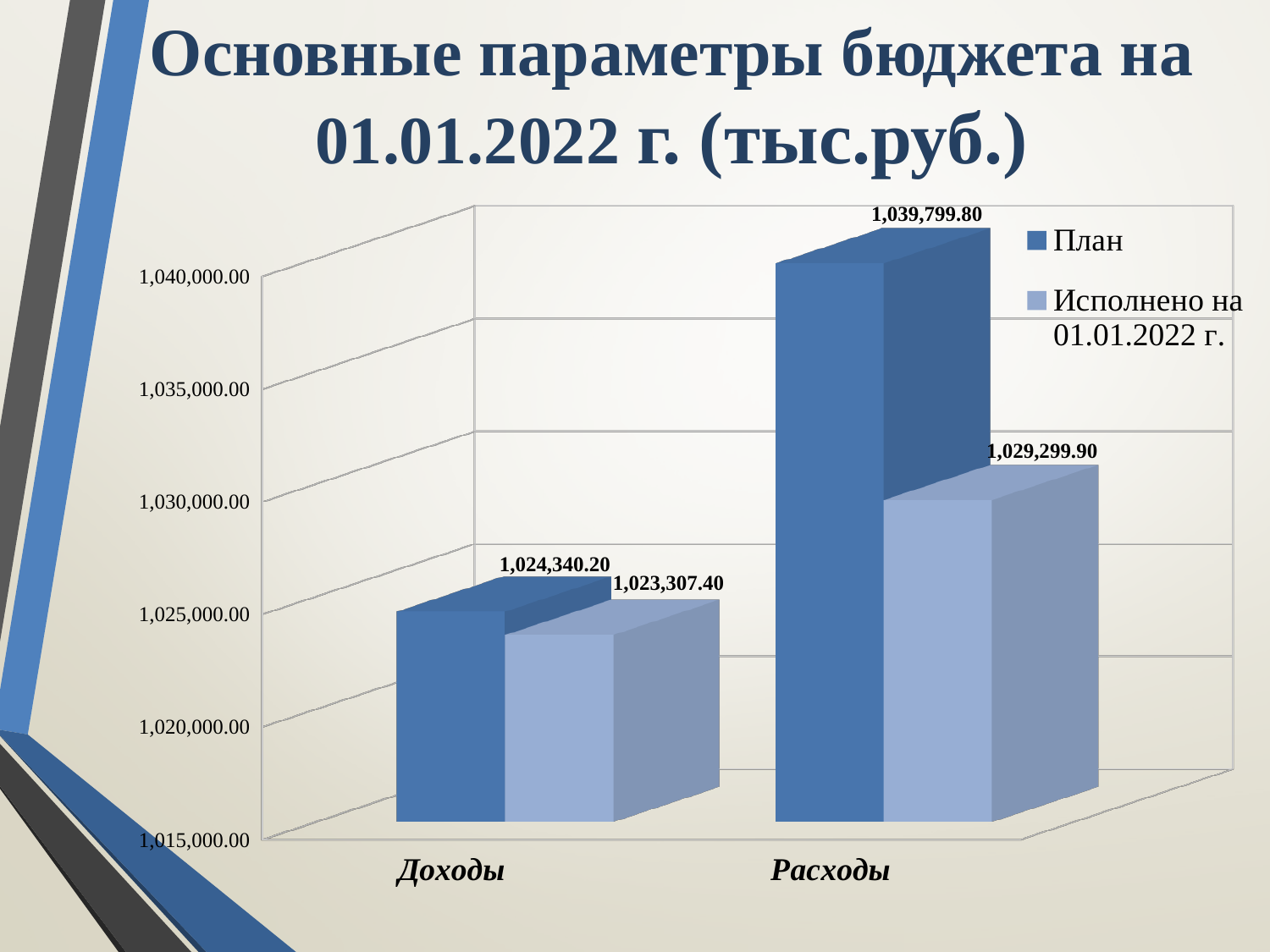
What is the difference between the План values for Расходы and Доходы? 15,459.60 What is the Исполнено на 01.01.2022 г. value for Доходы? 1,023,307.40 What is the difference between the План and Исполнено на 01.01.2022 г. values for Расходы? 10,499.90 How many series does the legend list? 2 Which is larger for Доходы: the План value or the Исполнено на 01.01.2022 г. value? План What is the План value for Расходы? 1,039,799.80 Which category has the lowest Исполнено на 01.01.2022 г. value? Доходы How many categories are shown on the x axis? 2 What is the План value for Доходы? 1,024,340.20 What is the Исполнено на 01.01.2022 г. value for Расходы? 1,029,299.90 Which category has the highest План value? Расходы What kind of chart is shown on the slide? Bar chart